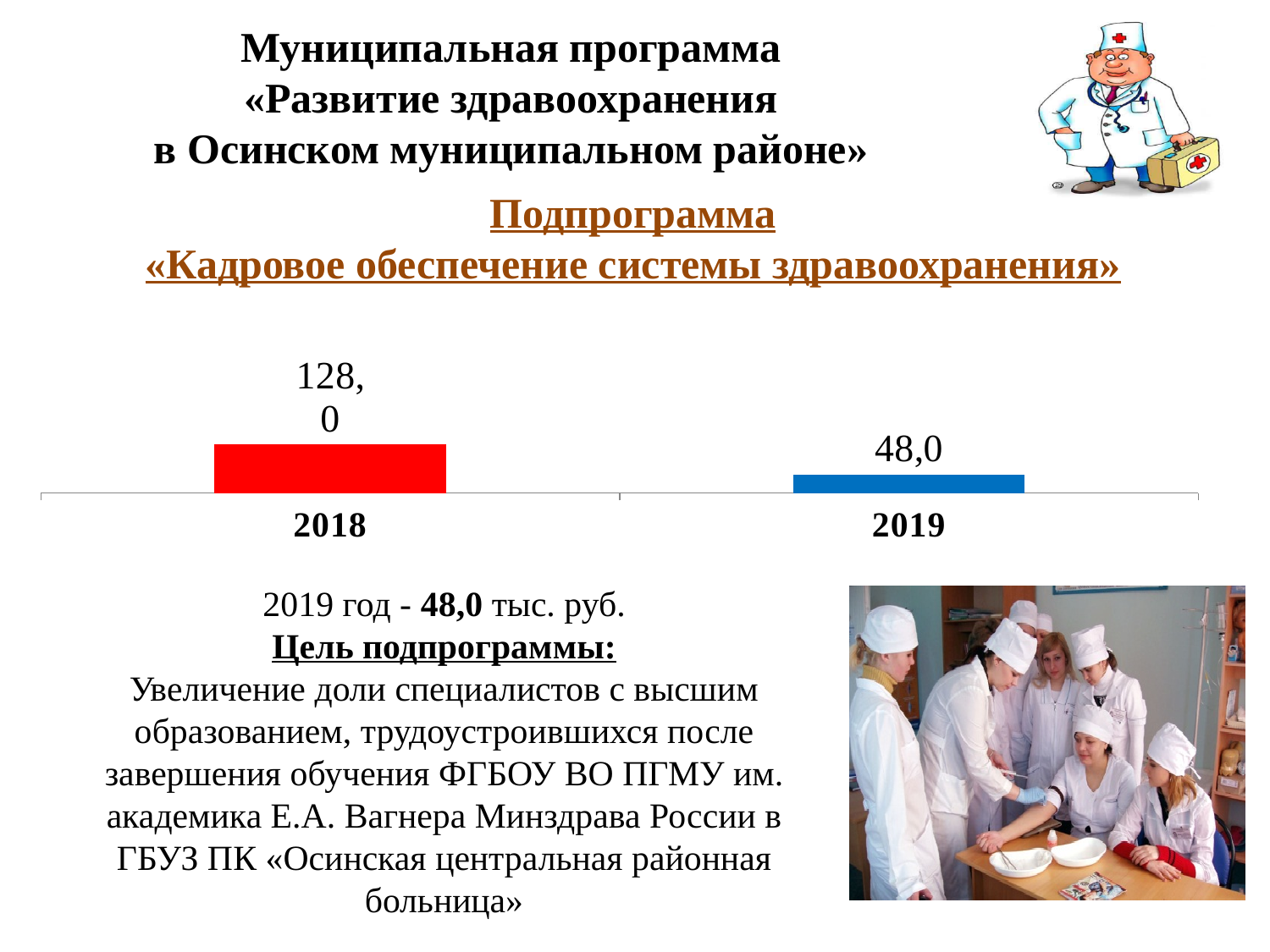
Which is larger, the value for 2018 or the value for 2019? 2018 Which year has the highest value in the bar chart? 2018 What is the difference between the values for 2018 and 2019? 80,0 Do the values rise or fall from 2018 to 2019? fall How many categories are shown in the bar chart? 2 What is the value for 2019 in the bar chart? 48,0 What colour is the bar for 2019? blue Which year has the lowest value in the bar chart? 2019 What is the value for 2018 in the bar chart? 128,0 What kind of chart is shown on the slide? bar chart What colour is the bar for 2018? red